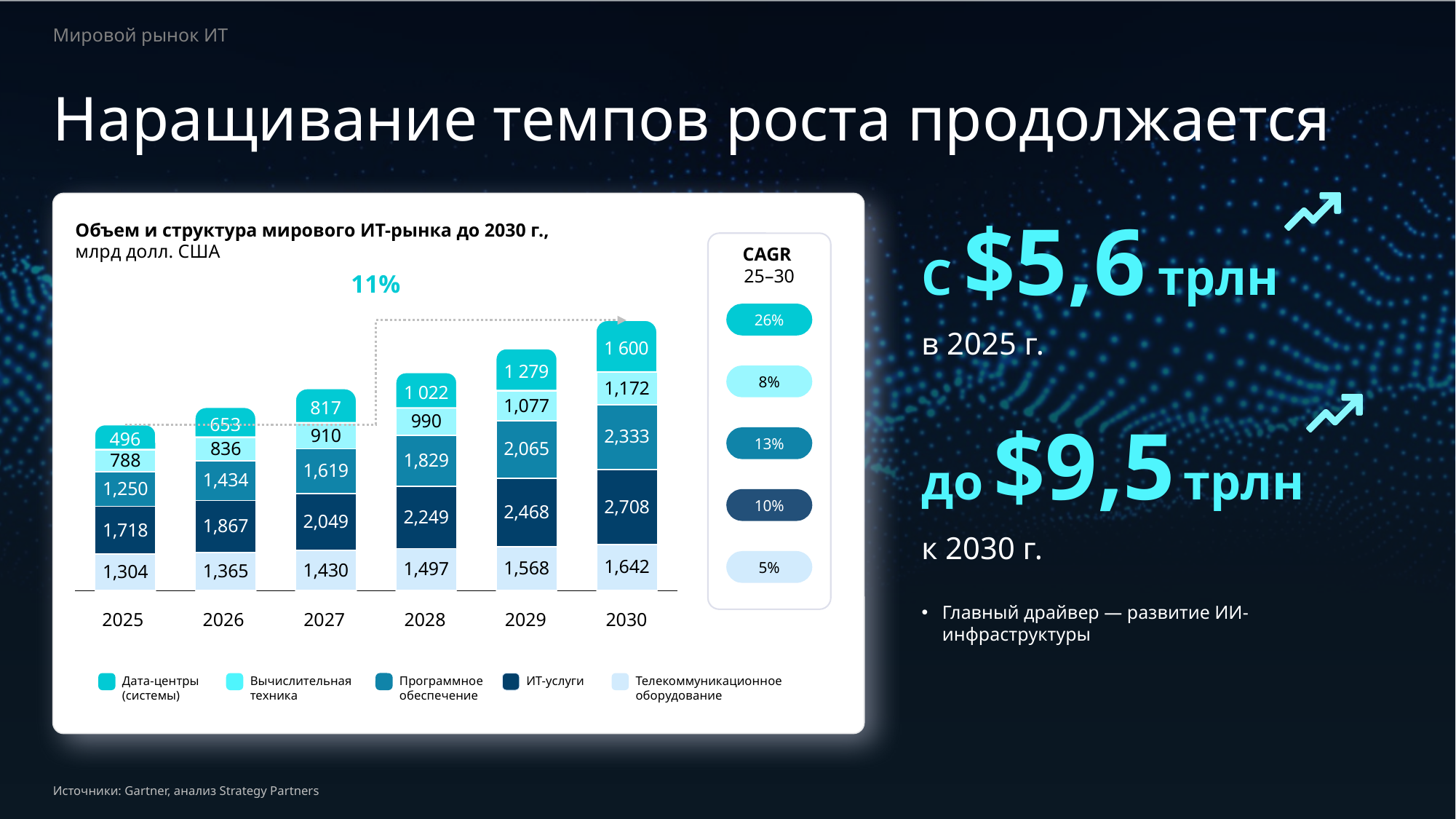
What kind of chart is shown on the slide? Stacked bar chart What is the total of the stacked bar for 2025? 5,556 How many series does the chart legend list? 5 By how much does the ИТ-услуги value in 2030 exceed the ИТ-услуги value in 2025? 990 In 2028, which is larger: Вычислительная техника or Программное обеспечение? Программное обеспечение What is the value for Дата-центры (системы) in 2030? 1 600 In which year is the Программное обеспечение segment the largest? 2030 Do the total bar heights rise or fall from 2025 to 2030? Rise Which segment is the smallest in the 2025 bar? Дата-центры (системы) What is the value for Телекоммуникационное оборудование in 2025? 1,304 What is the value for ИТ-услуги in 2027? 2,049 How many years are shown on the x axis of the chart? 6